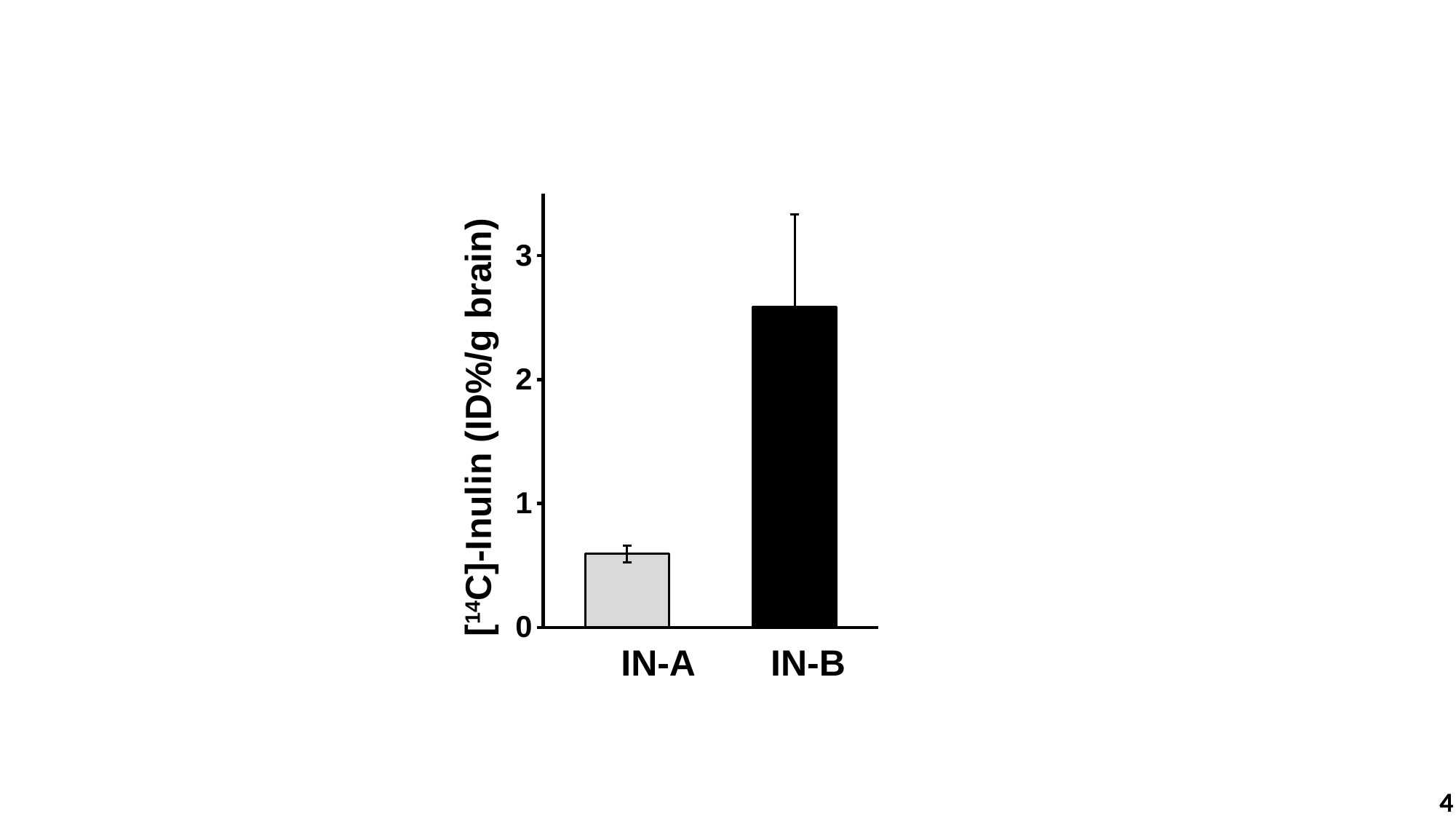
What kind of chart is shown on the slide? bar chart What colour is the bar for IN-B? black What is the label of the y axis? [14C]-Inulin (ID%/g brain) How many categories are plotted on the x axis? 2 Which is larger, the value for IN-A or the value for IN-B? IN-B Is the value for IN-B greater or less than 3? less Which category has the highest value? IN-B Which category has the lowest value? IN-A Is the value for IN-B greater or less than 2? greater Is the value for IN-A greater or less than 1? less